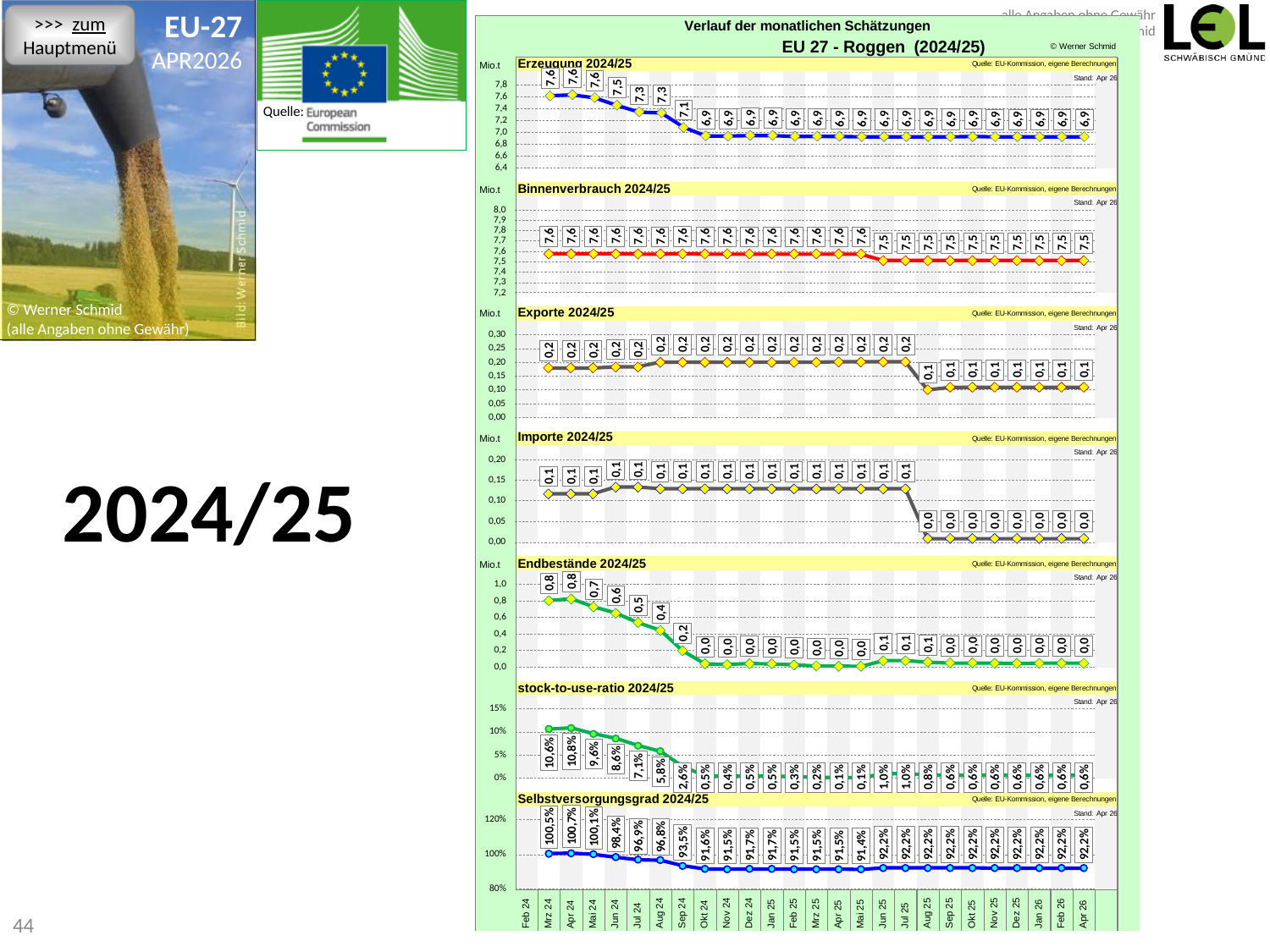
How many separate chart panels are shown on the slide? 7 In the Erzeugung 2024/25 chart, what is the difference between the highest value (7,6) and the lowest value (6,9)? 0,7 In the Erzeugung 2024/25 chart, what is the lowest value shown? 6,9 What is the main title of the chart panel on the slide? Verlauf der monatlichen Schätzungen EU 27 - Roggen (2024/25) In the Selbstversorgungsgrad 2024/25 chart, what is the lowest value shown? 91,4% In the Selbstversorgungsgrad 2024/25 chart, what is the highest value shown? 100,7% In the Endbestände 2024/25 chart, what is the highest value shown? 0,8 In the Erzeugung 2024/25 chart, what is the highest value shown? 7,6 What type of charts are shown on the slide? line charts In the stock-to-use-ratio 2024/25 chart, what is the lowest value shown? 0,1% In the Erzeugung 2024/25 chart, do the values rise or fall from left to right along the x axis? fall